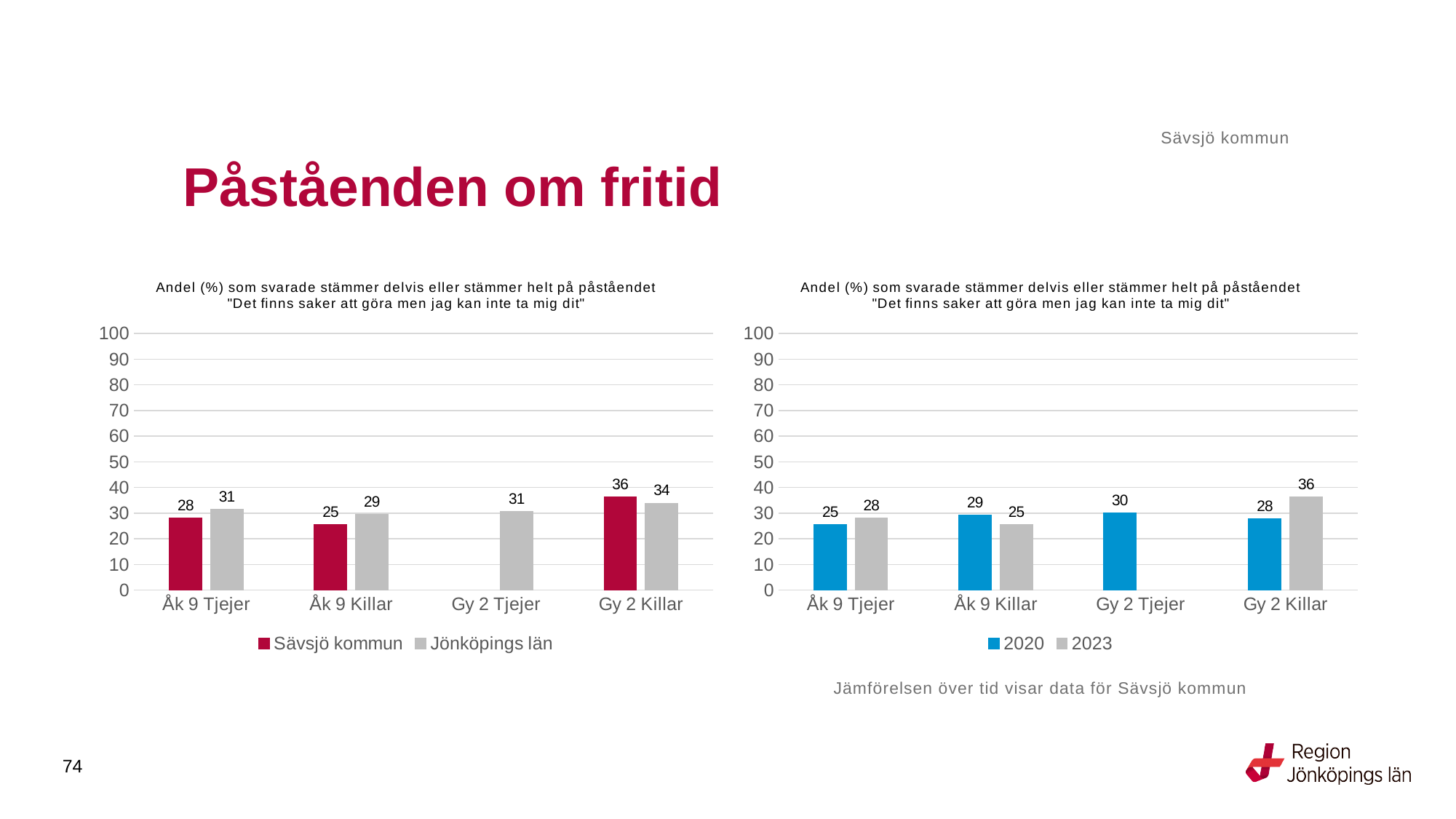
In the left chart, what is the value for Jönköpings län for Gy 2 Tjejer? 31 In the left chart, how many series does the legend list? 2 In the left chart, which category has the lowest value for Jönköpings län? Åk 9 Killar In the left chart, what is the difference between Sävsjö kommun and Jönköpings län for Gy 2 Killar? 2 In the right chart, what is the value for 2020 for Gy 2 Tjejer? 30 In the right chart, what is the difference between 2023 and 2020 for Gy 2 Killar? 8 In the right chart, which is larger for Åk 9 Killar, 2020 or 2023? 2020 In the right chart, what is the value for 2023 for Gy 2 Killar? 36 In the left chart, what is the value for Sävsjö kommun for Åk 9 Tjejer? 28 In the left chart, which category has the highest value for Sävsjö kommun? Gy 2 Killar What kind of chart is the right chart? Bar chart In the right chart, how many categories are shown on the x axis? 4